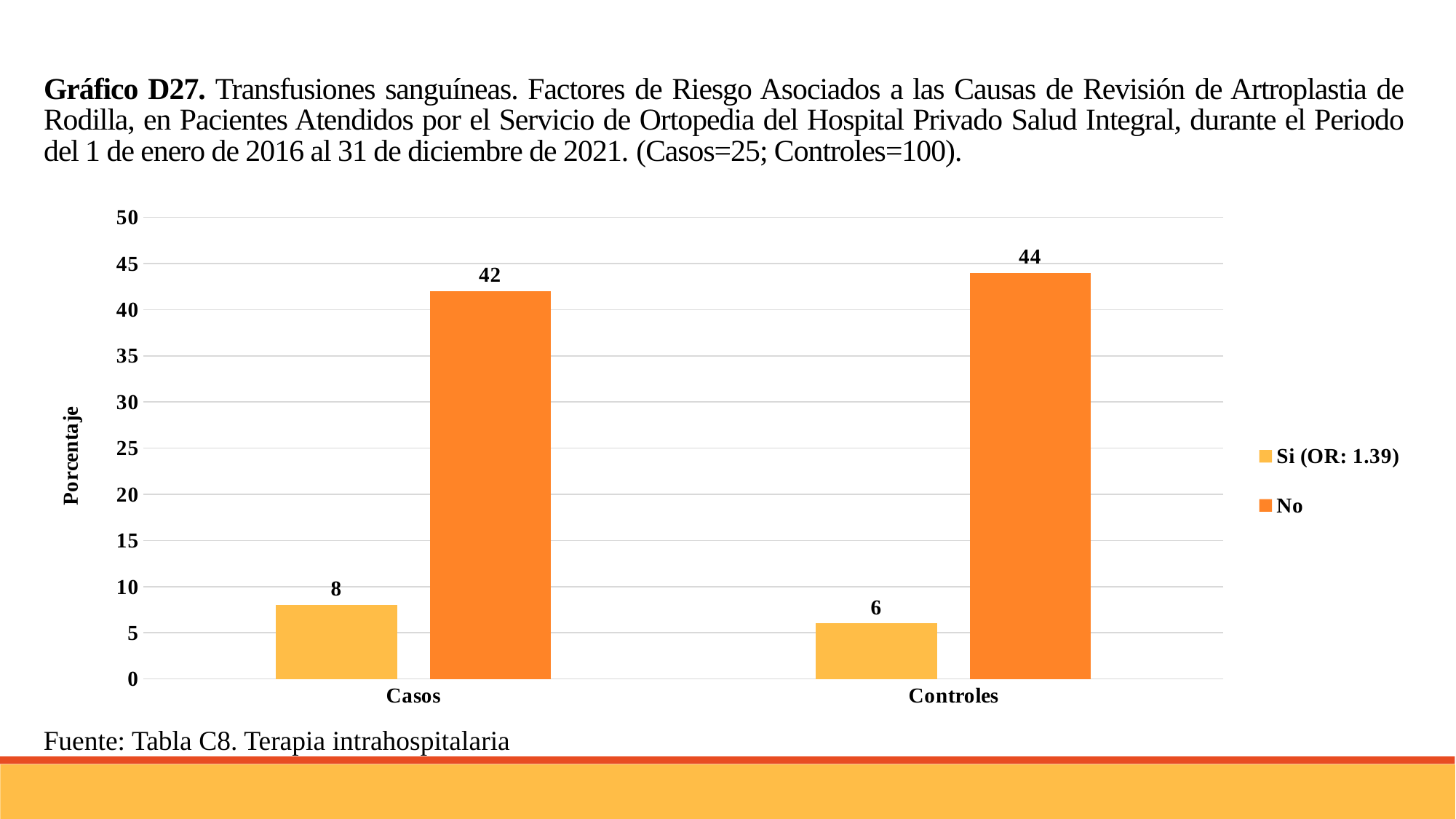
What is the value for 'Si (OR: 1.39)' in the Controles category? 6 What is the value for 'No' in the Casos category? 42 What is the difference between the 'No' value and the 'Si (OR: 1.39)' value for Casos? 34 What is the difference between the 'No' values for Controles and Casos? 2 Which category has the highest 'No' value? Controles What kind of chart is shown on the slide? Bar chart What is the value for 'Si (OR: 1.39)' in the Casos category? 8 What is the value for 'No' in the Controles category? 44 Which is larger: the 'Si (OR: 1.39)' value for Casos or for Controles? Casos How many categories are shown on the x axis? 2 How many series does the legend list? 2 Which category has the lowest 'Si (OR: 1.39)' value? Controles